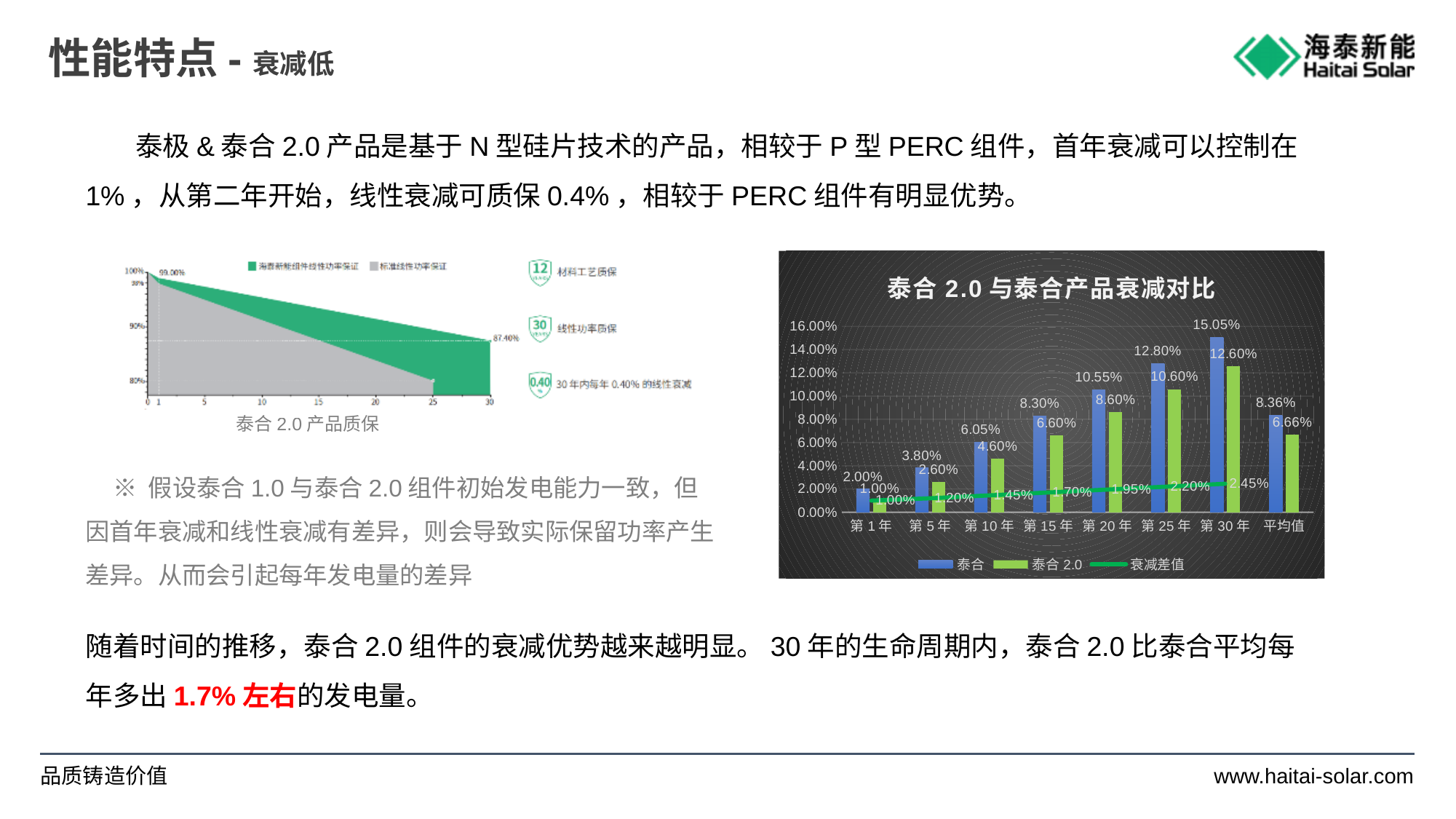
In the chart titled 泰合 2.0 与泰合产品衰减对比, how many series does the legend list? 3 In the chart titled 泰合 2.0 与泰合产品衰减对比, at which category is the 泰合 bar highest? 第 30 年 In the chart titled 泰合 2.0 与泰合产品衰减对比, what is the value for 泰合 2.0 at 第 20 年? 8.60% In the chart titled 泰合 2.0 与泰合产品衰减对比, which is larger at 第 10 年: 泰合 or 泰合 2.0? 泰合 In the chart titled 泰合 2.0 与泰合产品衰减对比, what is the 衰减差值 value at 第 15 年? 1.70% In the chart on the left titled 泰合 2.0 产品质保, what power percentage is labelled at year 30 for the green series? 87.40% In the chart titled 泰合 2.0 与泰合产品衰减对比, at which category is the 泰合 2.0 bar lowest? 第 1 年 In the chart titled 泰合 2.0 与泰合产品衰减对比, does the 衰减差值 line rise or fall from 第 1 年 to 第 30 年? rise In the chart titled 泰合 2.0 与泰合产品衰减对比, what is the 平均值 for 泰合 2.0? 6.66% In the chart titled 泰合 2.0 与泰合产品衰减对比, how many categories are shown on the x axis? 8 In the chart titled 泰合 2.0 与泰合产品衰减对比, what is the difference between the 泰合 and 泰合 2.0 values at 第 25 年? 2.20% In the chart titled 泰合 2.0 与泰合产品衰减对比, what is the value for 泰合 at 第 30 年? 15.05%